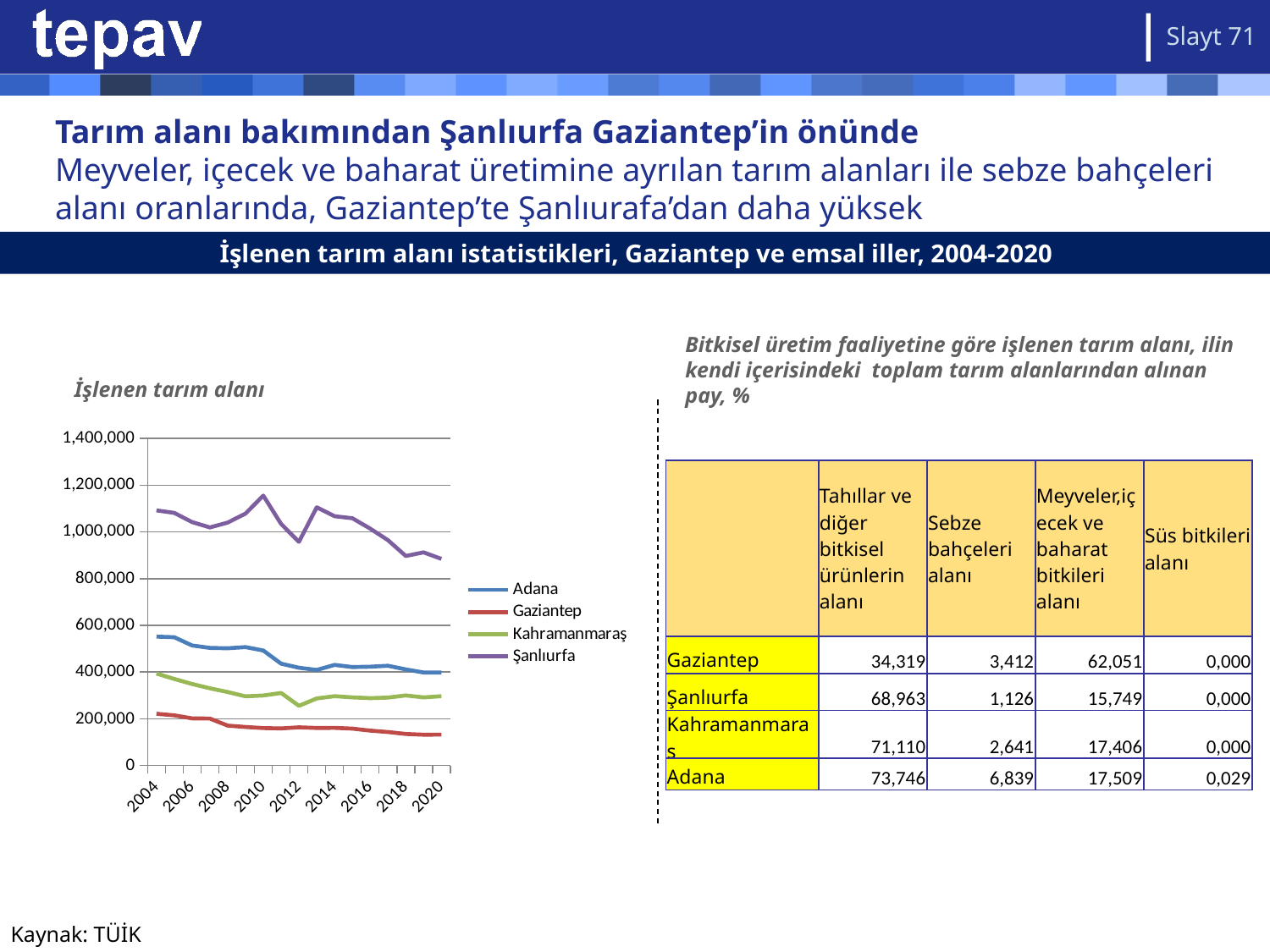
In the "İşlenen tarım alanı" chart, does the Şanlıurfa series rise or fall overall from 2004 to 2020? fall In the "İşlenen tarım alanı" chart, is the value for Şanlıurfa in 2004 greater or less than 1,000,000? greater How many series does the legend of the "İşlenen tarım alanı" chart list? 4 What is the first year shown on the x axis of the "İşlenen tarım alanı" chart? 2004 Which series has the highest values throughout the "İşlenen tarım alanı" chart? Şanlıurfa In the "İşlenen tarım alanı" chart, is the value for Gaziantep in 2020 greater or less than 200,000? less What kind of chart is the "İşlenen tarım alanı" chart? line chart In the "İşlenen tarım alanı" chart, is the value for Şanlıurfa in 2020 greater or less than 1,000,000? less In the "İşlenen tarım alanı" chart, which is larger in 2004: Adana or Kahramanmaraş? Adana Which series has the lowest values throughout the "İşlenen tarım alanı" chart? Gaziantep